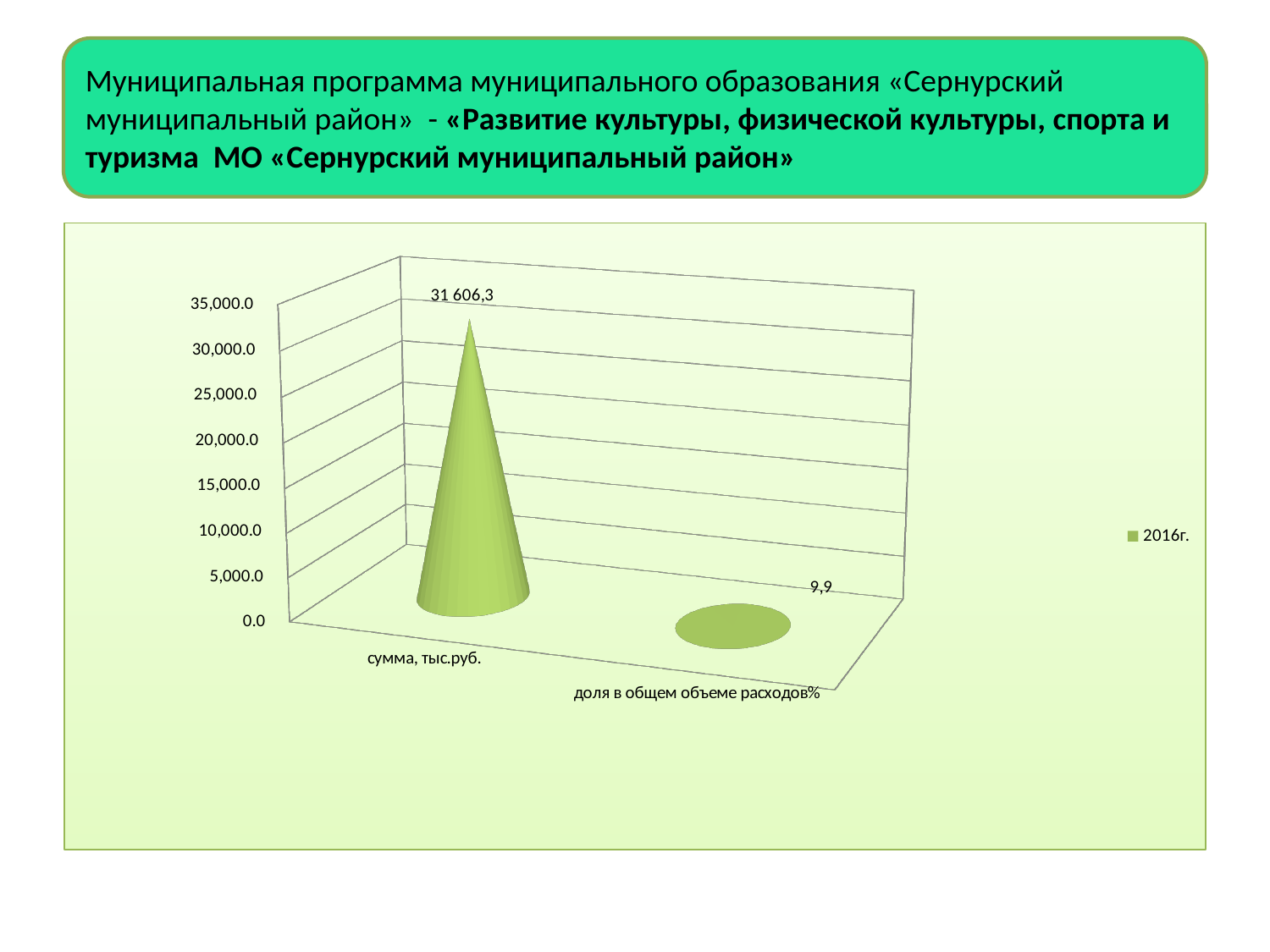
What series name is shown in the chart legend? 2016г. How many categories are shown on the chart's x axis? 2 Is the value for «доля в общем объеме расходов%» greater or less than 5,000.0? less How many series does the chart legend list? 1 Which category has the highest value in the chart? сумма, тыс.руб. What kind of chart is shown on the slide? bar chart What is the value for «сумма, тыс.руб.» in the chart? 31 606,3 Is the value for «сумма, тыс.руб.» greater or less than 30,000.0? greater What is the value for «доля в общем объеме расходов%» in the chart? 9,9 What is the highest value shown on the chart's vertical axis? 35,000.0 Which is larger: the value for «сумма, тыс.руб.» or the value for «доля в общем объеме расходов%»? сумма, тыс.руб. Which category has the lowest value in the chart? доля в общем объеме расходов%